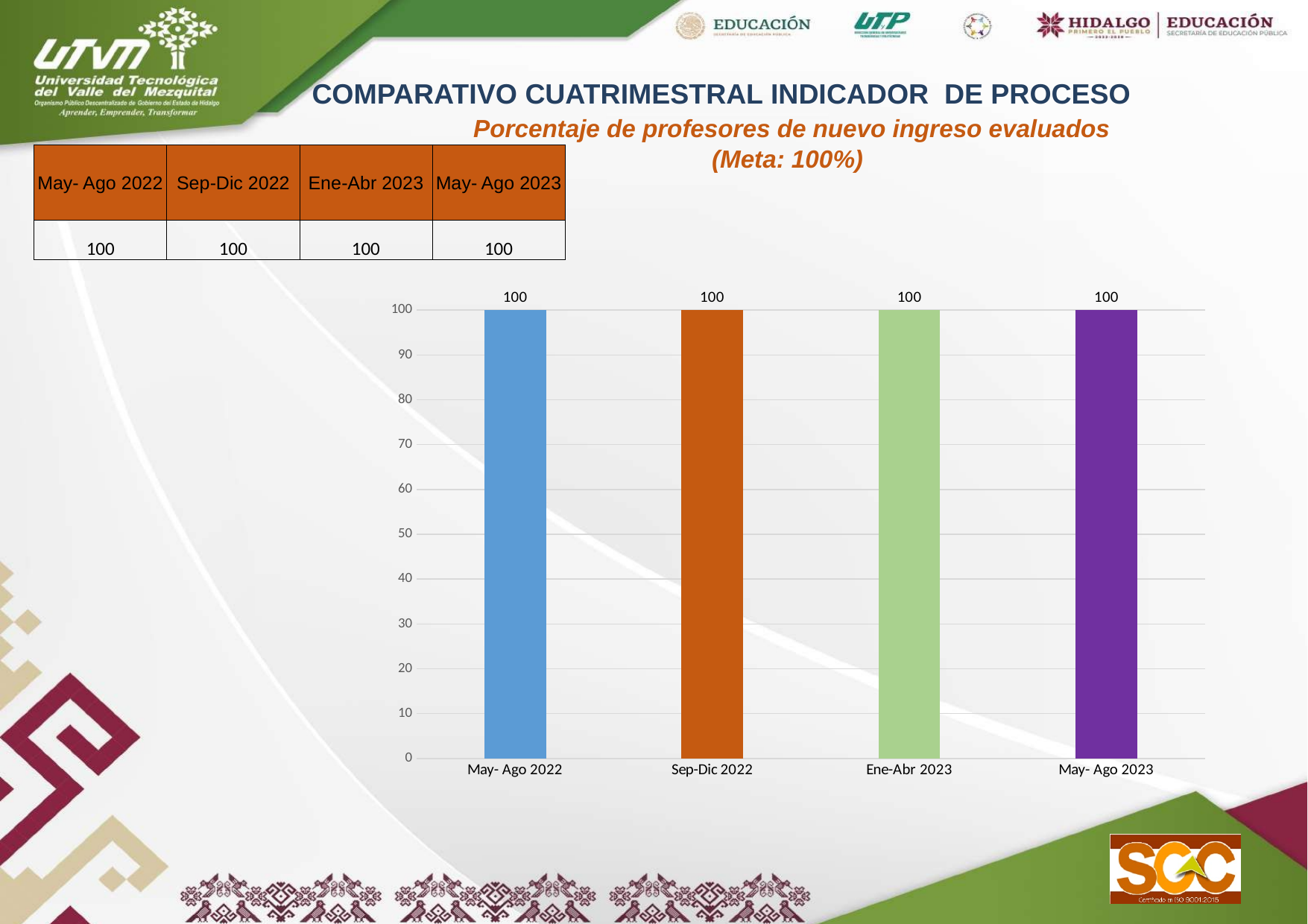
What is the target (Meta) stated in the chart subtitle? 100% Is the value for Sep-Dic 2022 greater or less than 90? greater What is the value for Ene-Abr 2023? 100 What is the value for May- Ago 2023? 100 What is the difference between the values for May- Ago 2022 and May- Ago 2023? 0 What is the value for May- Ago 2022? 100 How many categories are shown on the x axis of the chart? 4 What is the highest value shown on the y axis of the chart? 100 What is the value for Sep-Dic 2022? 100 Is the value for Ene-Abr 2023 greater or less than 50? greater Do the values rise, fall, or stay flat from May- Ago 2022 to May- Ago 2023? stay flat What kind of chart is shown on the slide? bar chart